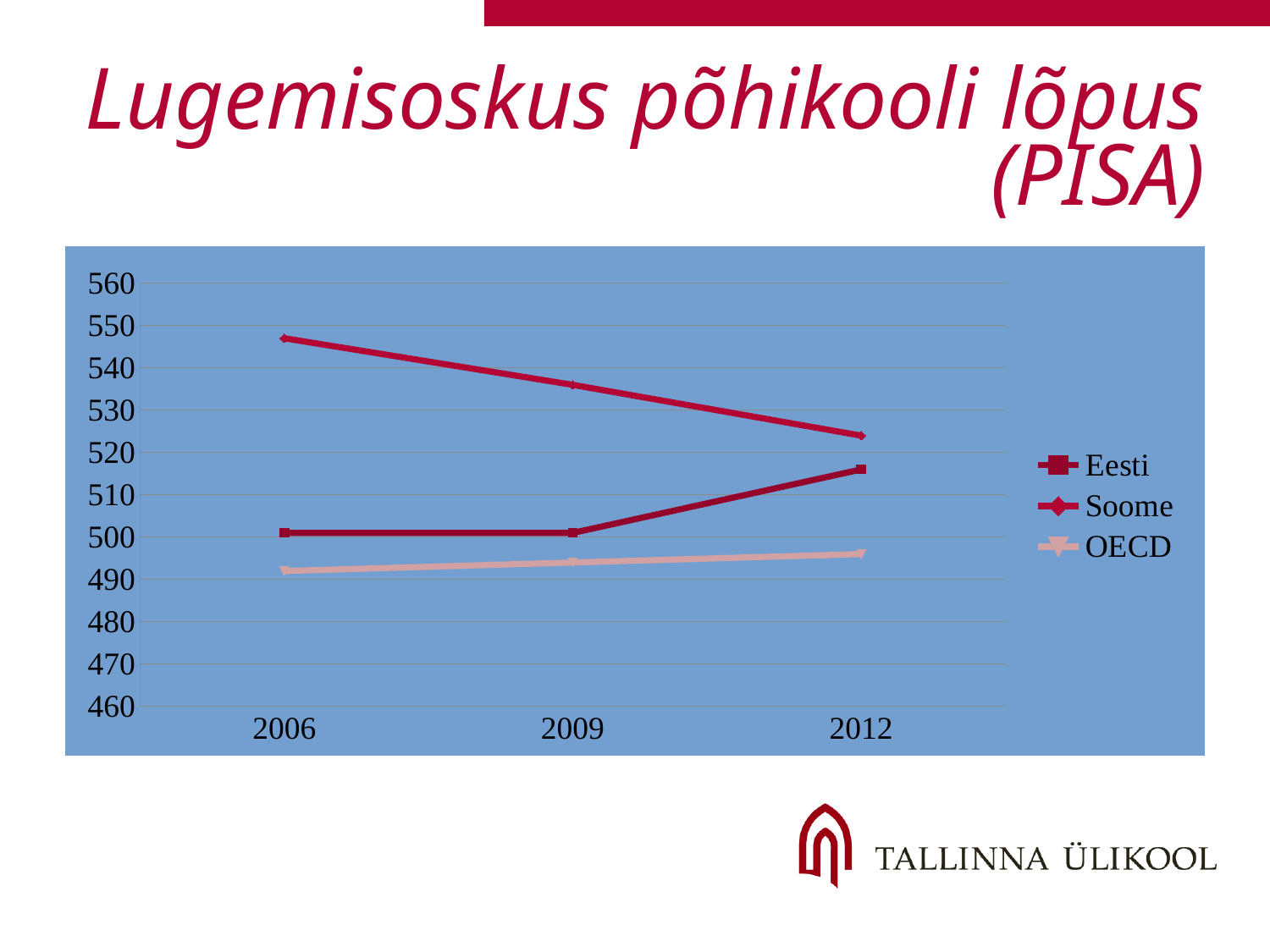
Which series has the highest value in 2006? Soome What kind of chart is shown on the slide? line chart Which series is drawn with the lightest (pale pink) line? OECD Does the OECD line rise or fall from 2006 to 2012? rise Is the value for Soome in 2006 greater or less than 540? greater How many series does the legend list? 3 Which series has the lowest value in 2012? OECD Is the value for Soome in 2012 greater or less than 520? greater Is the value for OECD in 2006 greater or less than 500? less How many years are shown on the x axis? 3 Does the Soome line rise or fall from 2006 to 2012? fall In 2012, which is larger, the value for Eesti or the value for Soome? Soome